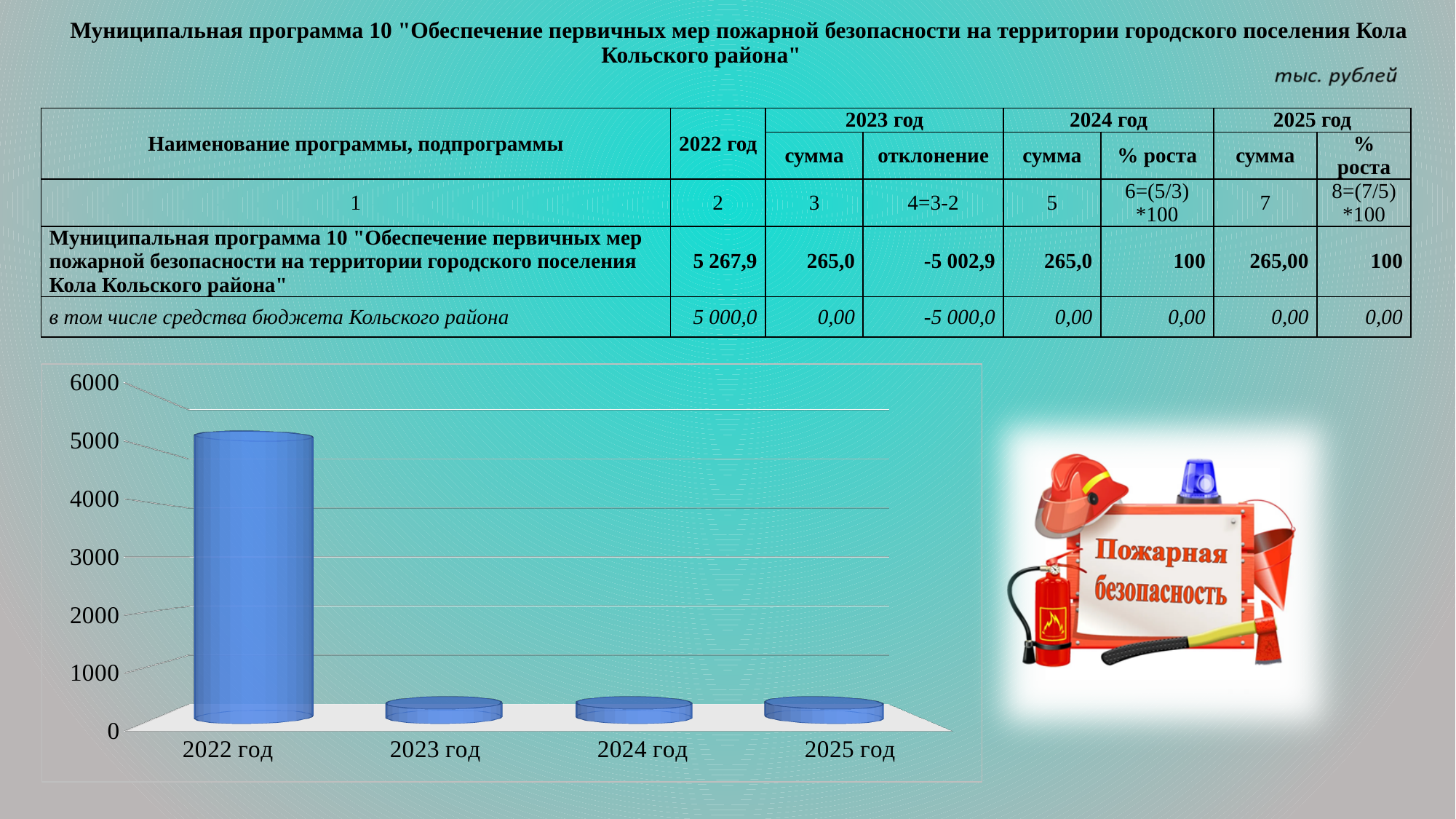
What kind of chart is shown on the slide? bar chart Which year has the highest bar in the chart? 2022 год Is the value for 2023 год greater or less than 1000? less Which is larger, the value for 2022 год or the value for 2024 год? 2022 год What is the highest tick value shown on the vertical axis of the chart? 6000 Do the values rise or fall from 2022 год to 2023 год? fall How many categories (years) are shown on the x axis of the chart? 4 What colour are the bars in the chart? blue Is the value for 2025 год greater or less than 1000? less Is the value for 2022 год greater or less than 5000? greater